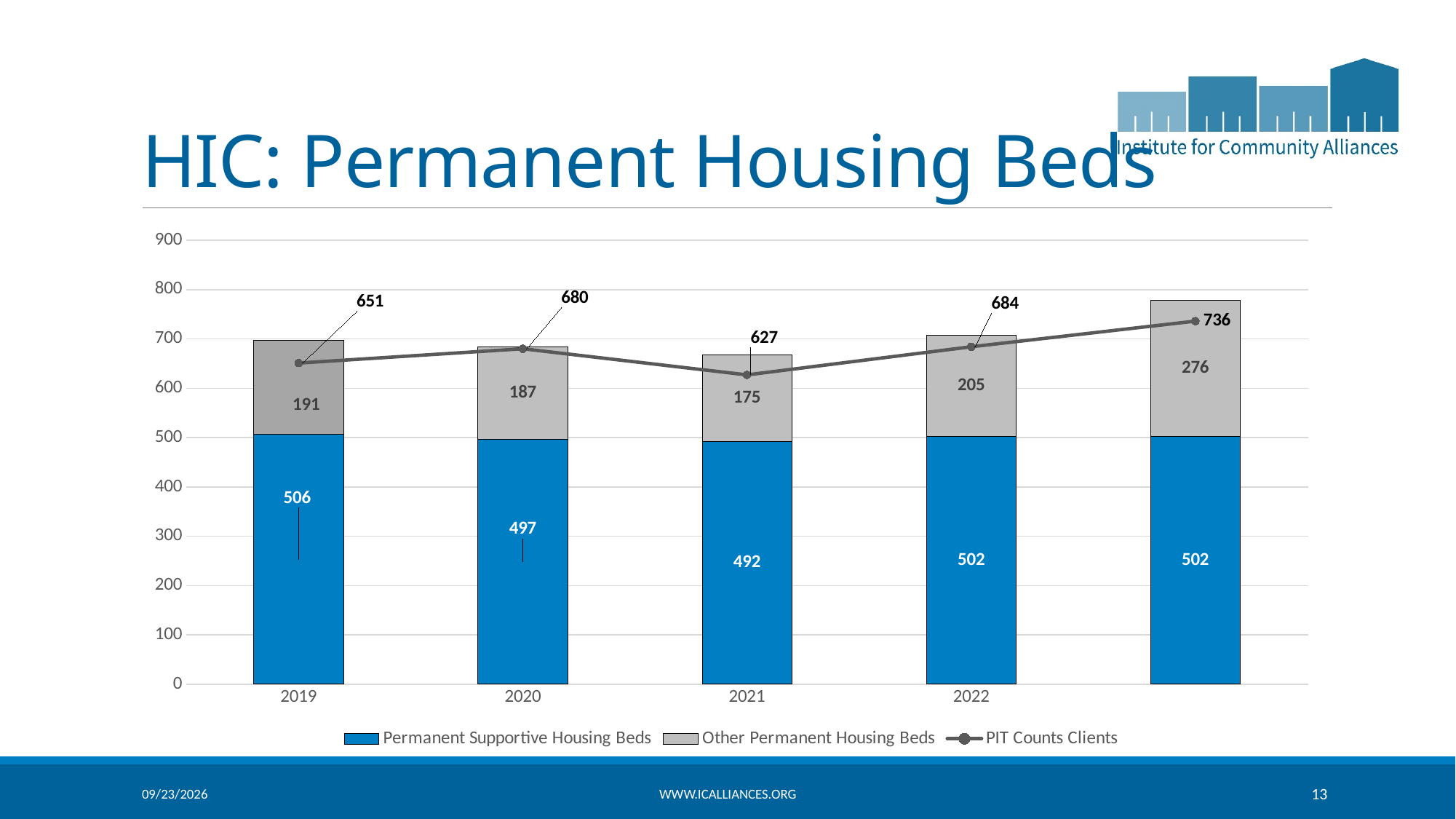
Does the PIT Counts Clients line rise or fall from 2021 to 2022? Rises By how much did PIT Counts Clients increase from 2019 to 2020? 29 Which year has the highest number of Permanent Supportive Housing Beds? 2019 What is the PIT Counts Clients value for 2021? 627 How many series does the legend list? 3 What kind of chart is shown on the slide? Stacked bar chart with a line What is the value for Other Permanent Housing Beds in 2022? 205 Which year has the lowest PIT Counts Clients value? 2021 How many Permanent Supportive Housing Beds are shown for 2019? 506 Which year has the lowest number of Other Permanent Housing Beds? 2021 What is the total number of permanent housing beds (both bar segments) for 2022? 707 Which year had more Permanent Supportive Housing Beds, 2020 or 2021? 2020